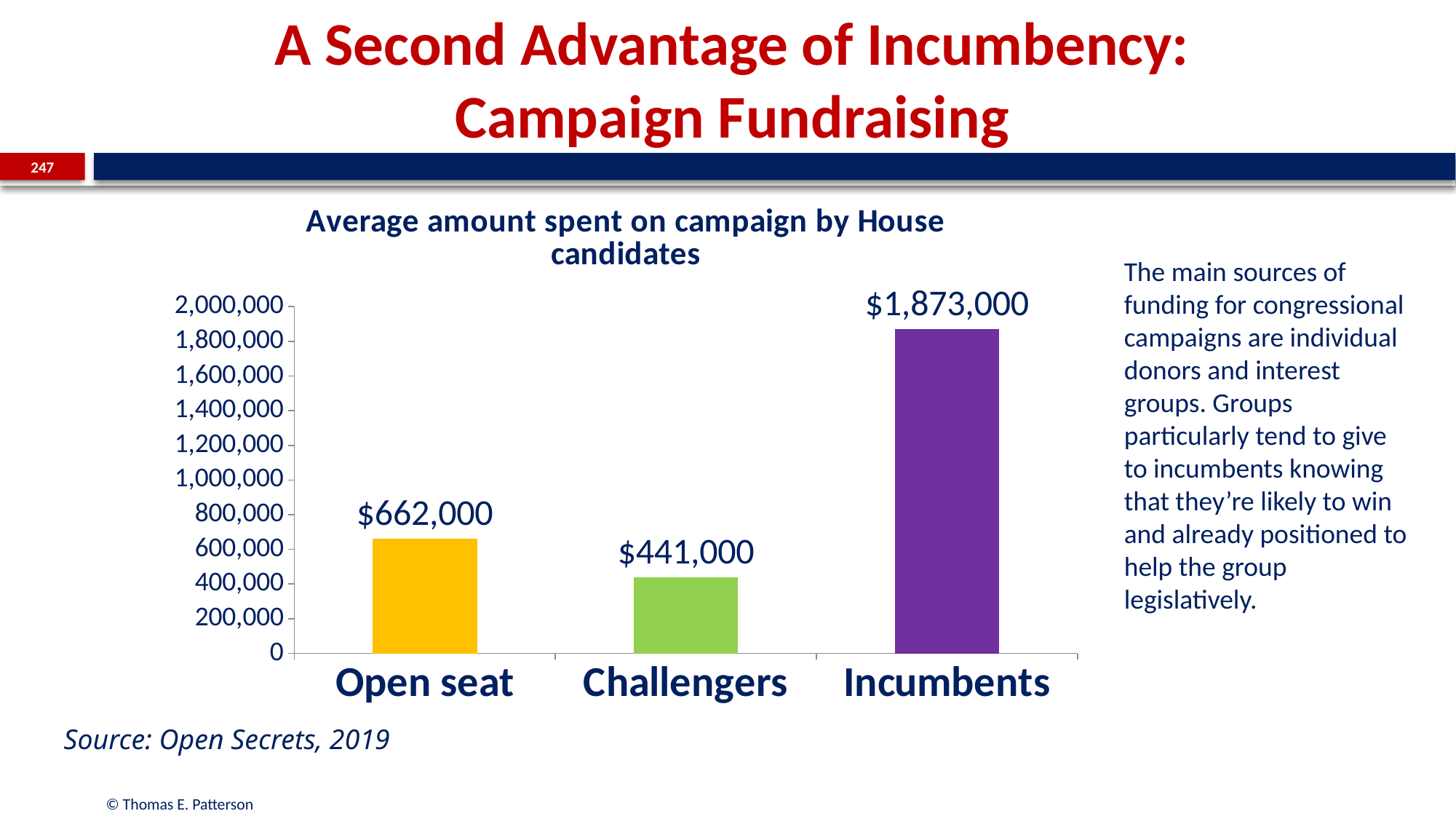
Which spent more on average, Open seat candidates or Challengers? Open seat What kind of chart is shown on the slide? Bar chart Is the value for Incumbents greater or less than 1,800,000? greater What is the title of the chart? Average amount spent on campaign by House candidates What is the average amount spent on campaign by Open seat House candidates? $662,000 What is the difference between the average amount spent by Open seat candidates and by Challengers? $221,000 What is the average amount spent on campaign by Incumbents? $1,873,000 How many categories are shown on the chart? 3 Which category has the lowest average amount spent? Challengers What is the difference between the average amount spent by Incumbents and by Challengers? $1,432,000 Which category has the highest average amount spent? Incumbents What is the average amount spent on campaign by Challengers? $441,000